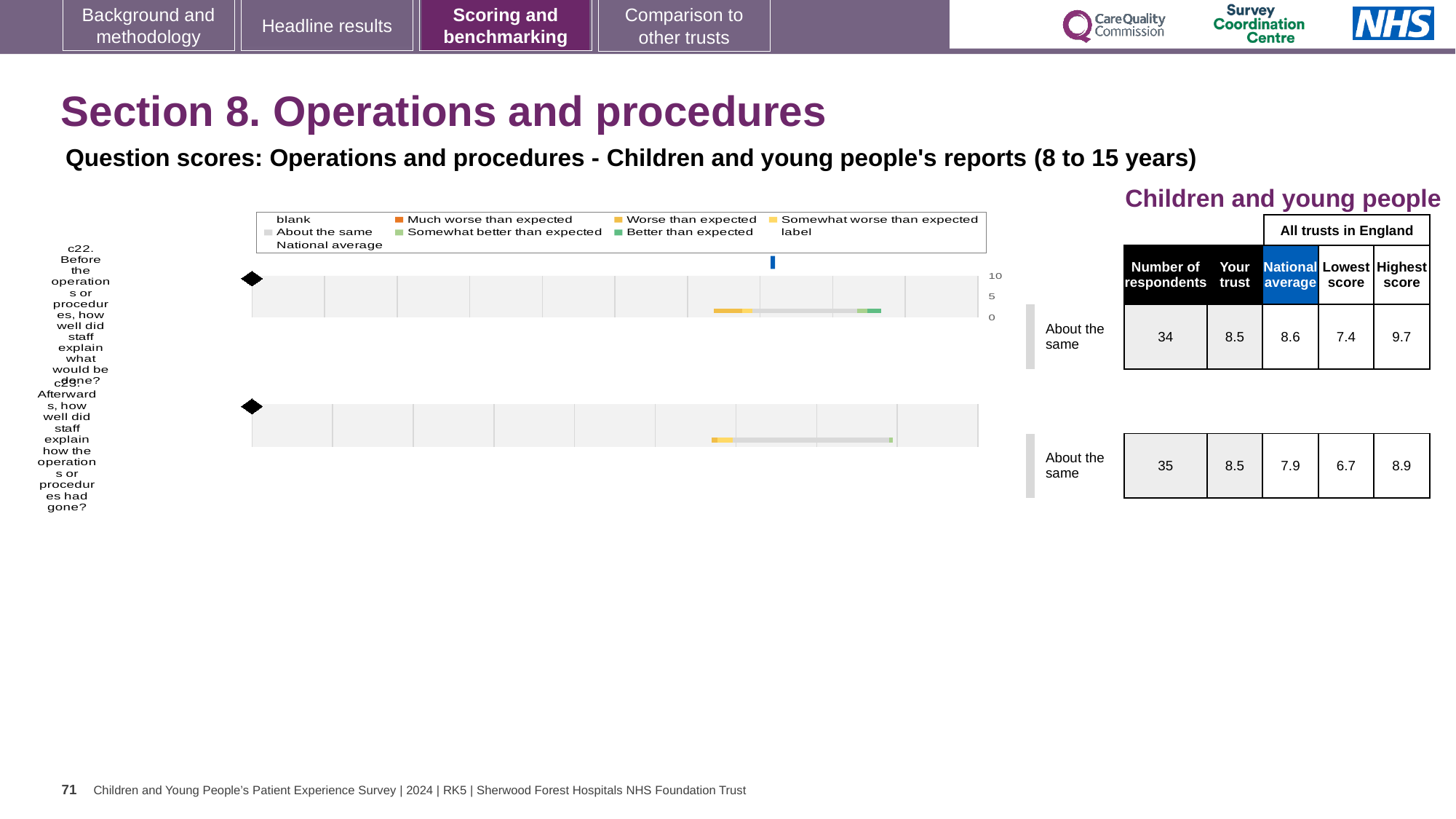
For c22, what is the difference between the highest score and the lowest score among all trusts in England? 2.3 For c22, which is larger: the 'Your trust' score or the national average? National average For c22, what is the lowest score among all trusts in England? 7.4 For c23, what is the highest score among all trusts in England? 8.9 For c23, what is the difference between the 'Your trust' score and the national average? 0.6 For c22 (Before the operations or procedures, how well did staff explain what would be done?), what is the 'Your trust' score? 8.5 What kind of chart is used to show the question scores for c22 and c23? bar chart For c23, which is larger: the 'Your trust' score or the national average? Your trust How many questions (c22 and c23) are plotted on the slide? 2 For c23 (Afterwards, how well did staff explain how the operations or procedures had gone?), how many respondents are there? 35 What benchmark category is shown for c23? About the same For c22, what is the national average score? 8.6